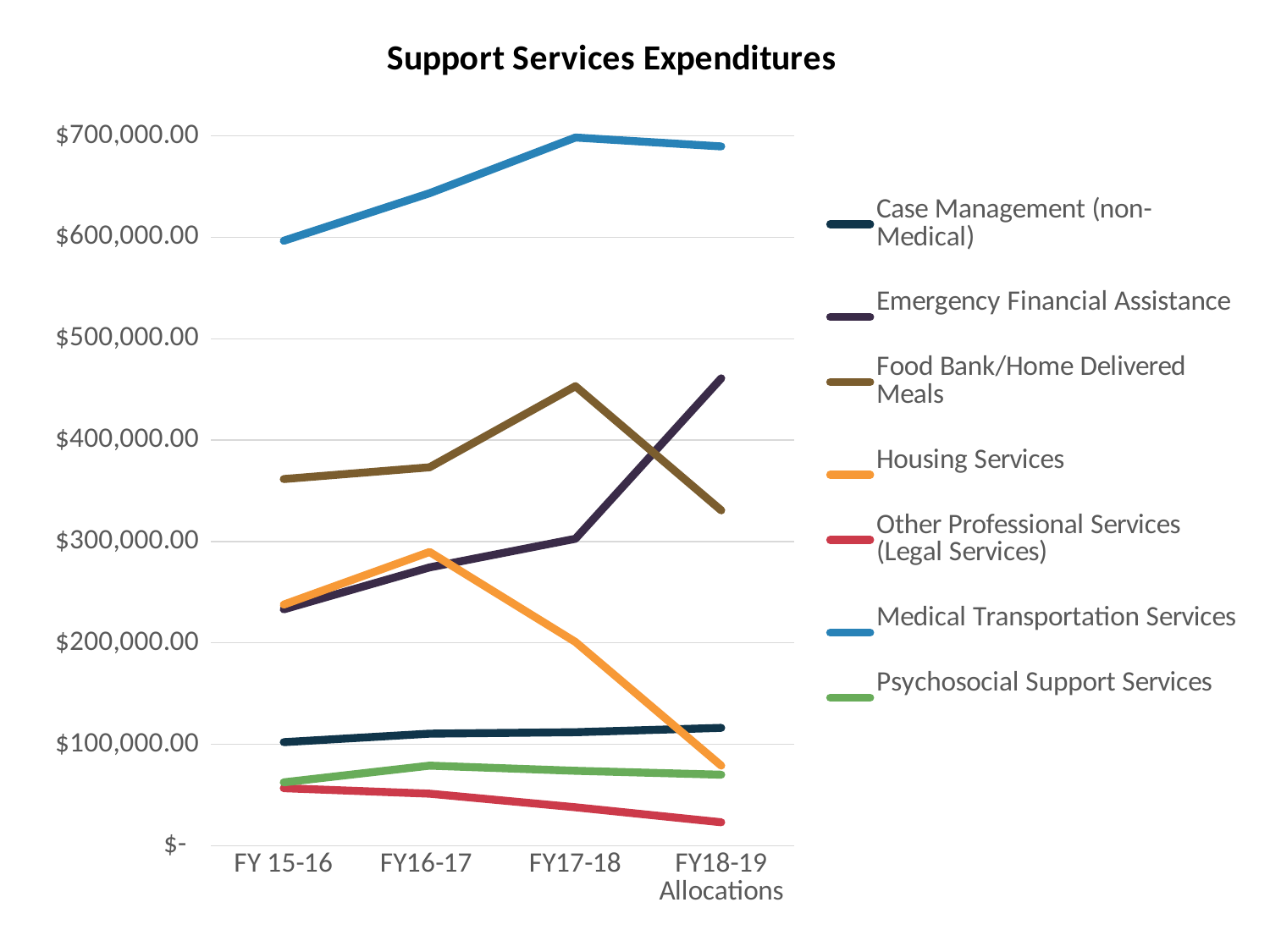
How many fiscal-year points are shown along the x axis? 4 Do the values for Other Professional Services (Legal Services) rise or fall from FY 15-16 to FY18-19 Allocations? fall Do the values for Emergency Financial Assistance rise or fall from FY 15-16 to FY18-19 Allocations? rise Which service has the lowest value in FY18-19 Allocations? Other Professional Services (Legal Services) Is the value for Medical Transportation Services in FY17-18 greater or less than $600,000.00? greater Is the value for Housing Services in FY18-19 Allocations greater or less than $100,000.00? less In FY18-19 Allocations, which is larger: Emergency Financial Assistance or Food Bank/Home Delivered Meals? Emergency Financial Assistance Is the value for Food Bank/Home Delivered Meals in FY17-18 greater or less than $400,000.00? greater Which service had the highest expenditure in FY17-18? Medical Transportation Services How many series does the legend list? 7 What kind of chart is shown on the slide? line chart What is the title of the chart? Support Services Expenditures